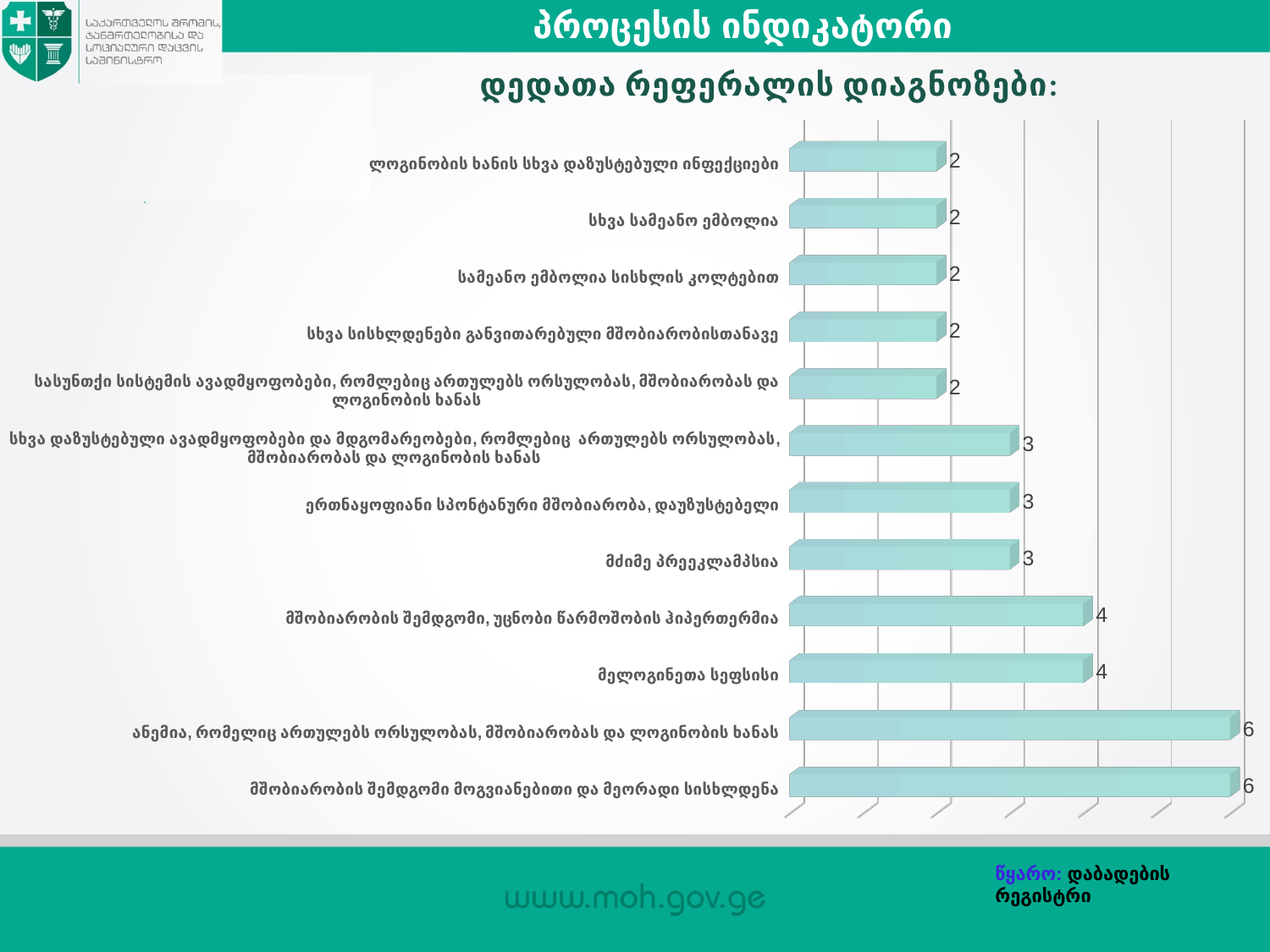
What is the title of the chart? დედათა რეფერალის დიაგნოზები: What is the highest value shown in the chart? 6 What is the difference between the value for ანემია, რომელიც ართულებს ორსულობას, მშობიარობას და ლოგინობის ხანას and the value for მძიმე პრეეკლამფსია? 3 What is the value for მძიმე პრეეკლამფსია? 3 What is the value for ერთნაყოფიანი სპონტანური მშობიარობა, დაუზუსტებელი? 3 What is the lowest value shown in the chart? 2 Which has a larger value: მელოგინეთა სეფსისი or სხვა სამეანო ემბოლია? მელოგინეთა სეფსისი What is the value for მელოგინეთა სეფსისი? 4 What is the value for სხვა სამეანო ემბოლია? 2 How many categories (bars) are shown in the chart? 12 What type of chart is shown on the slide? bar chart What is the value for ანემია, რომელიც ართულებს ორსულობას, მშობიარობას და ლოგინობის ხანას? 6